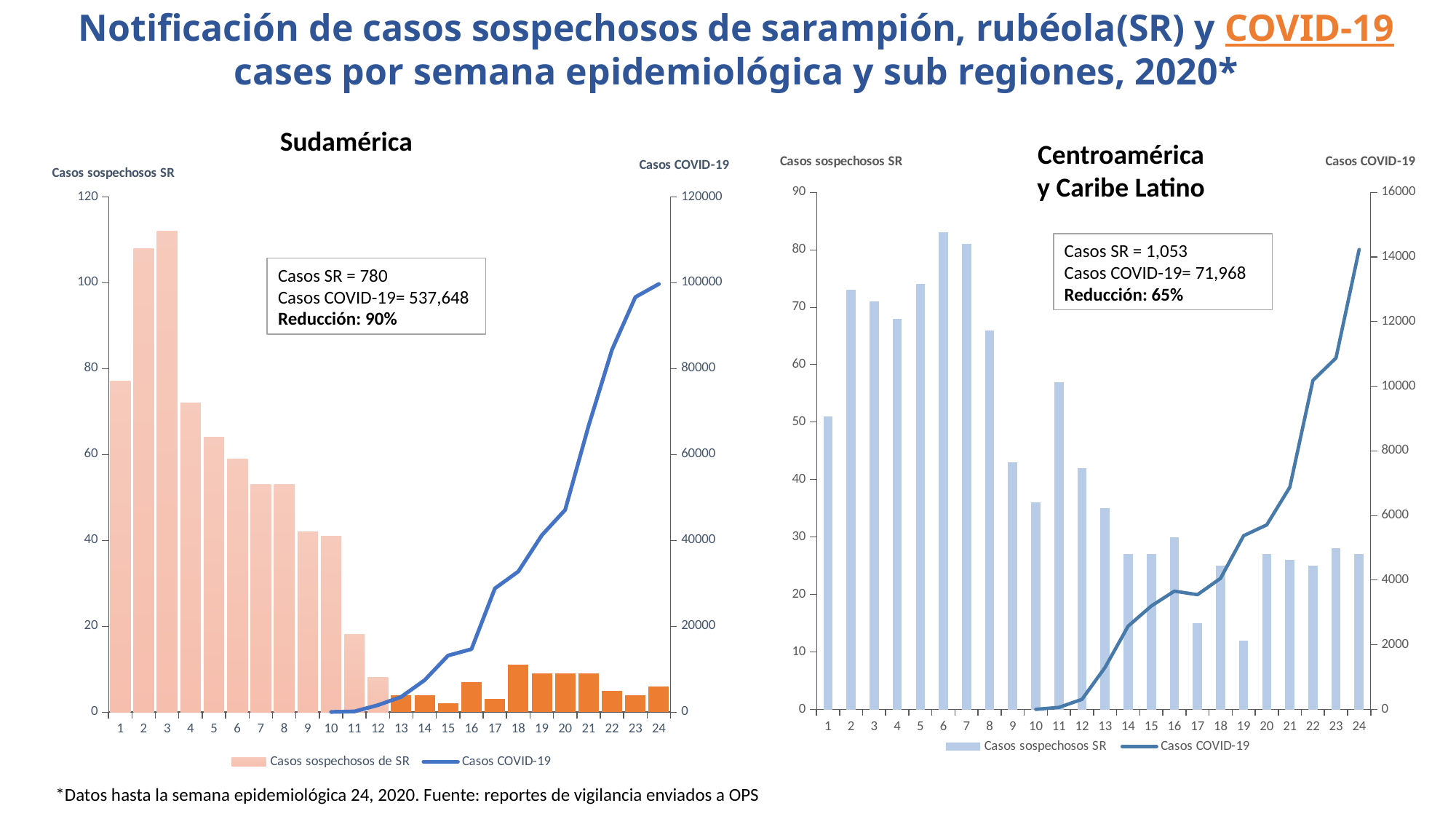
On the Sudamérica chart, does the Casos COVID-19 line rise or fall from week 10 to week 24? Rises On the Sudamérica chart, which week has more suspected SR cases, week 2 or week 4? Week 2 On the Sudamérica chart, is the number of suspected SR cases in week 1 greater or less than 60? greater On the Centroamérica y Caribe Latino chart, is the COVID-19 value in week 24 greater or less than 12000? greater On the Centroamérica y Caribe Latino chart, which week has the lowest number of suspected SR cases? Week 19 What kind of chart is the Centroamérica y Caribe Latino chart? Combination bar and line chart On the Centroamérica y Caribe Latino chart, which week has the highest number of suspected SR cases? Week 6 According to the text box on the Sudamérica chart, what is the total number of Casos COVID-19? 537,648 On the Sudamérica chart, how many epidemiological weeks are shown on the x axis? 24 On the Sudamérica chart, which week has the highest number of suspected SR cases? Week 3 On the Sudamérica chart, how many series does the legend list? 2 On the Centroamérica y Caribe Latino chart, is the number of suspected SR cases in week 11 greater or less than 50? greater